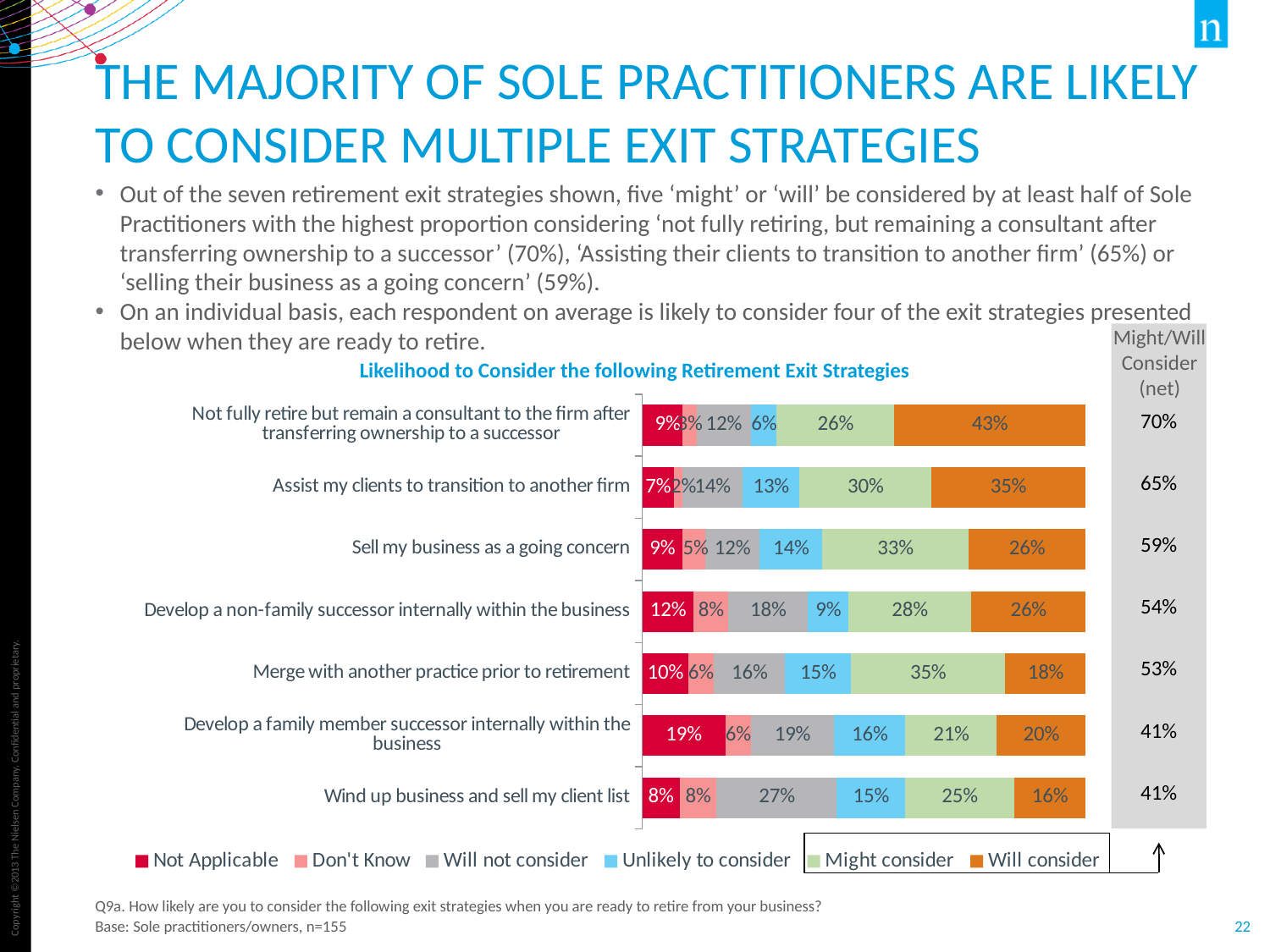
What is the Might/Will Consider (net) value shown for 'Sell my business as a going concern'? 59% Which exit strategy has the highest 'Will consider' percentage? Not fully retire but remain a consultant to the firm after transferring ownership to a successor Which exit strategy has the lowest 'Will consider' percentage? Wind up business and sell my client list How many series does the chart legend list? 6 What percentage 'Might consider' the strategy 'Merge with another practice prior to retirement'? 35% What percentage 'Will not consider' the strategy 'Wind up business and sell my client list'? 27% What is the title of the chart? Likelihood to Consider the following Retirement Exit Strategies What kind of chart is shown on the slide? Bar chart (stacked) What percentage 'Will consider' the strategy 'Not fully retire but remain a consultant to the firm after transferring ownership to a successor'? 43% How many retirement exit strategies (categories) are plotted in the chart? 7 Which has a larger 'Will consider' percentage: 'Assist my clients to transition to another firm' or 'Sell my business as a going concern'? Assist my clients to transition to another firm What is the difference in 'Will consider' percentage between 'Not fully retire but remain a consultant...' (43%) and 'Merge with another practice prior to retirement' (18%)? 25 percentage points